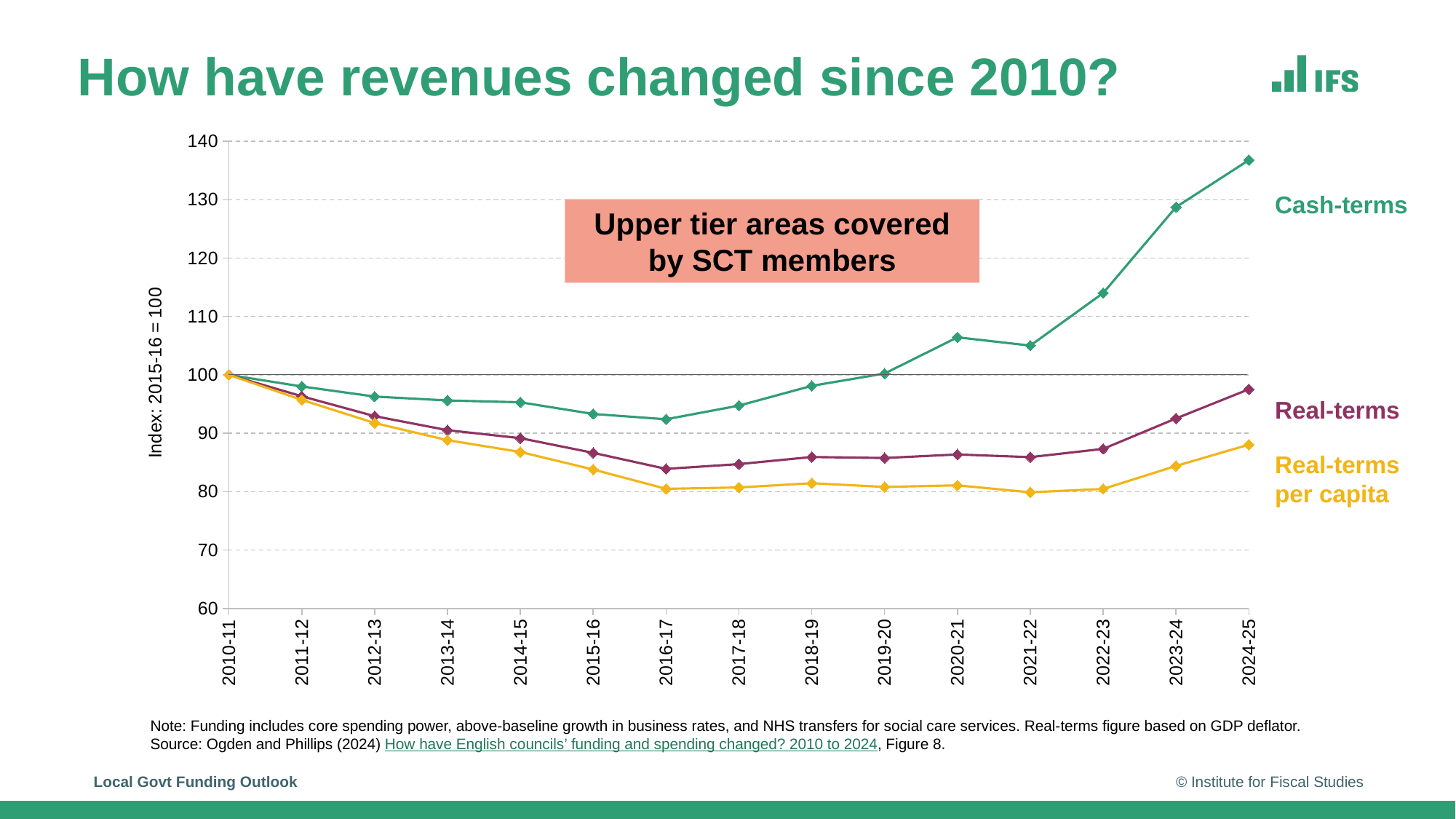
What text is shown in the highlighted box on the chart? Upper tier areas covered by SCT members What is the index value of the Cash-terms series in 2010-11? 100 How many series are plotted on the chart? 3 Which is larger: the Real-terms value in 2016-17 or the Real-terms value in 2024-25? 2024-25 Is the value for Real-terms in 2024-25 greater or less than 100? less Which series has the highest value in 2024-25? Cash-terms Is the value for Cash-terms in 2024-25 greater or less than 130? greater What kind of chart is shown on the slide? line chart Does the Cash-terms series rise or fall between 2019-20 and 2024-25? rise Is the value for Real-terms per capita in 2016-17 greater or less than 90? less Which series has the lowest value in 2024-25? Real-terms per capita How many financial years are shown along the x axis? 15